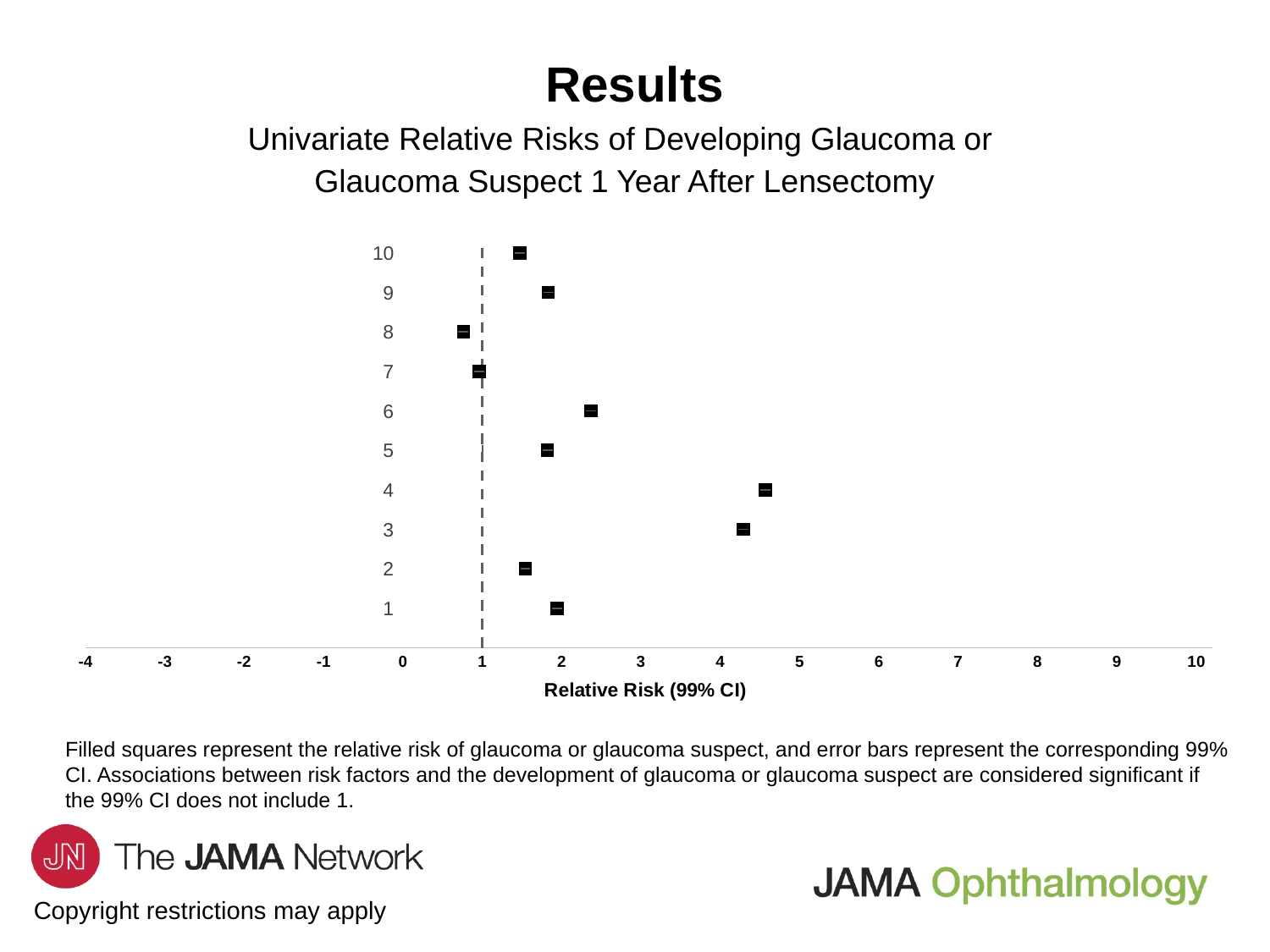
Is the relative risk for row 10 greater or less than 1? greater What kind of chart is shown on the slide? scatter chart Which row (1 to 10) has the lowest relative risk? 8 What is the title of the x axis? Relative Risk (99% CI) Which has the larger relative risk, row 6 or row 2? row 6 Is the relative risk for row 4 greater or less than 4? greater Which row (1 to 10) has the highest relative risk? 4 Which has the larger relative risk, row 9 or row 8? row 9 Is the relative risk for row 2 greater or less than 2? less How many data points are plotted on the chart? 10